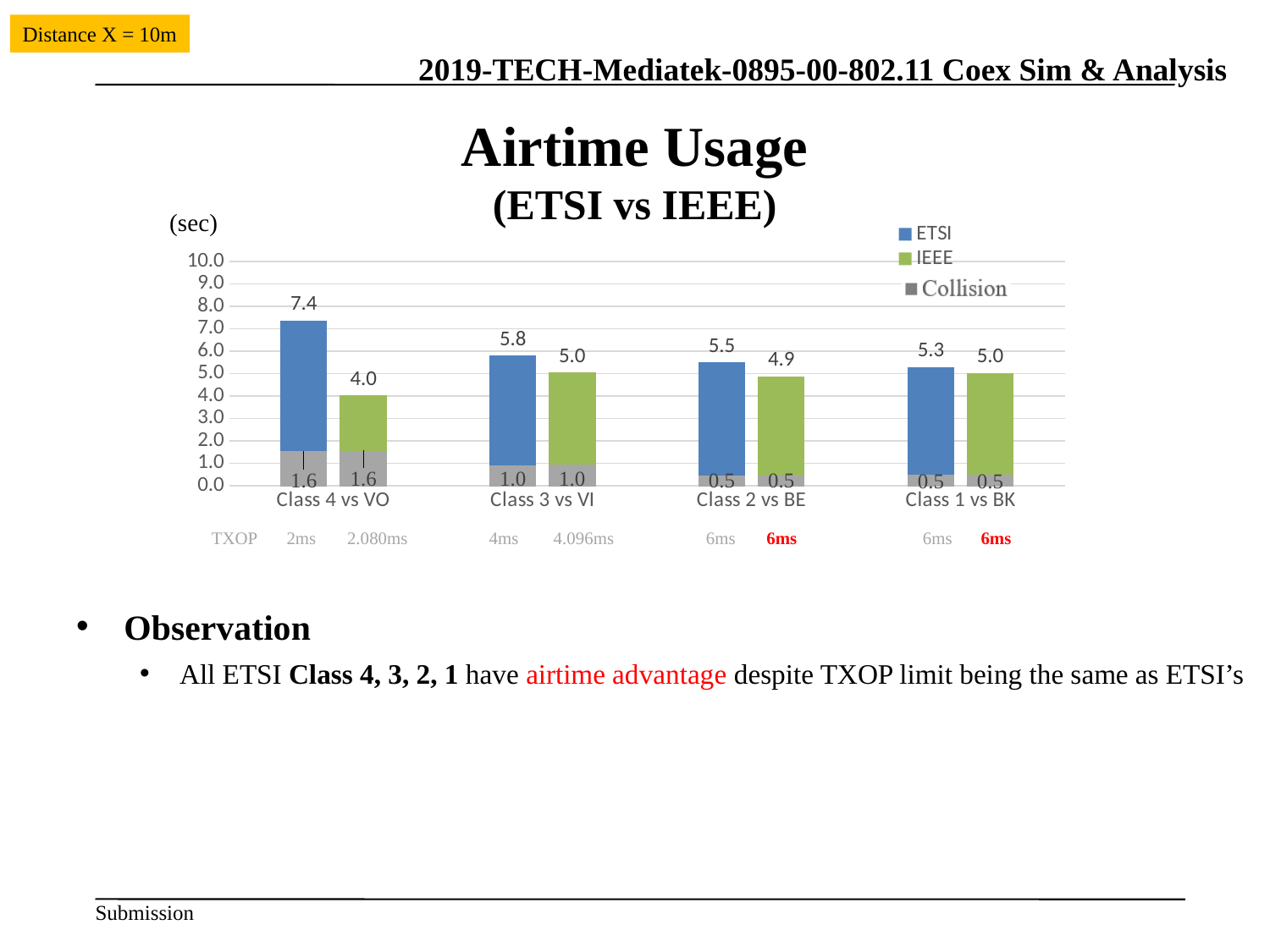
What is the difference between the ETSI and IEEE values for Class 3 vs VI? 0.8 What is the IEEE airtime value for Class 2 vs BE? 4.9 What is the difference between the ETSI and IEEE values for Class 4 vs VO? 3.4 Is the ETSI value for Class 2 vs BE greater or less than 5.0? greater What kind of chart is shown on the slide? Bar chart How many categories are shown on the x axis? 4 Which category has the lowest IEEE value? Class 4 vs VO Which category has the highest ETSI value? Class 4 vs VO What is the ETSI airtime value for Class 4 vs VO? 7.4 How many series does the legend list? 3 Which is larger for Class 1 vs BK, the ETSI value or the IEEE value? ETSI What is the collision value shown for Class 3 vs VI? 1.0